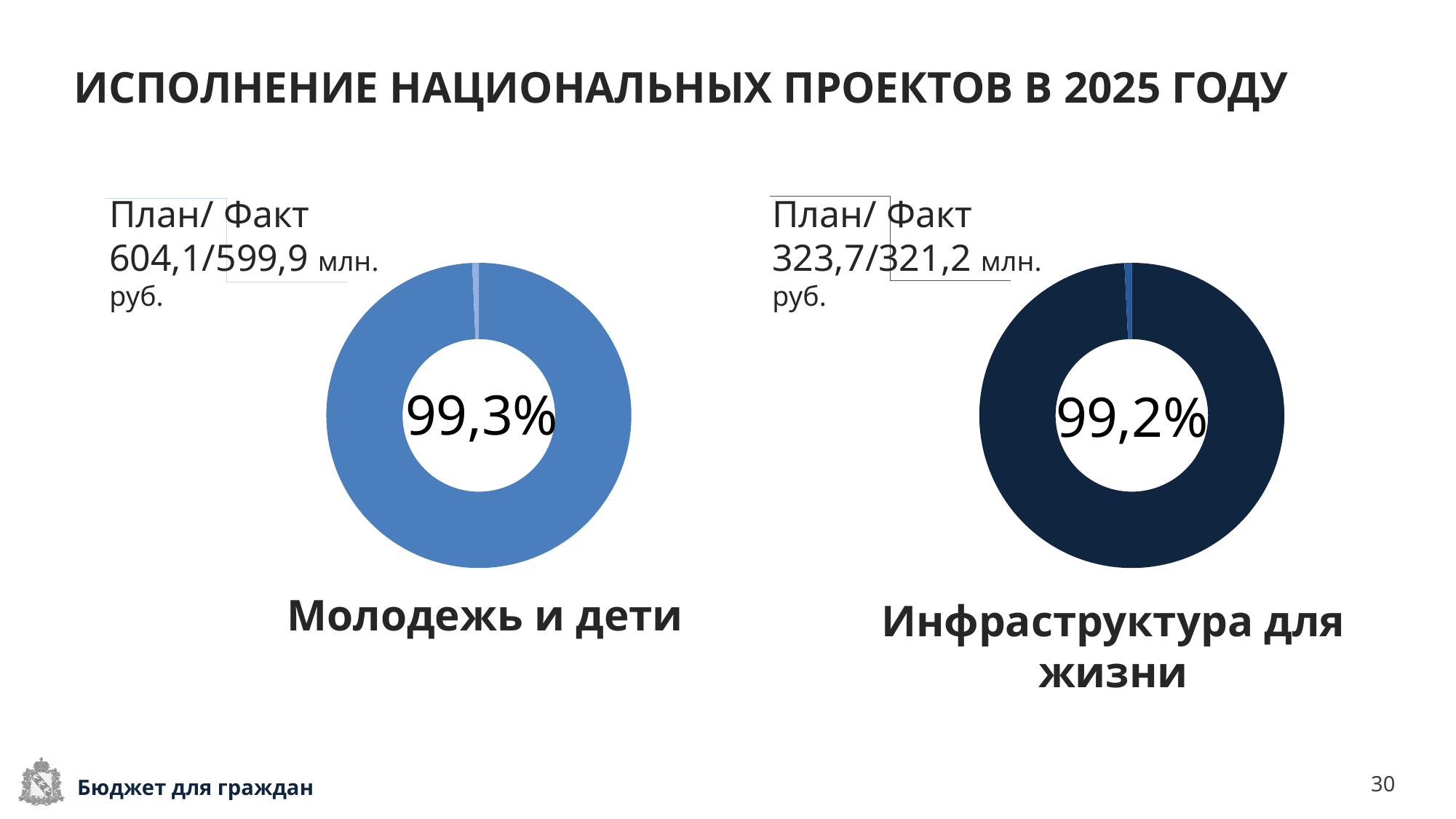
Which of the two national projects on the slide has the higher execution percentage? Молодежь и дети In the chart titled "Инфраструктура для жизни", what is the difference between the planned and actual amounts in млн. руб.? 2,5 How many donut charts are shown on the slide? 2 What is the title of the slide? ИСПОЛНЕНИЕ НАЦИОНАЛЬНЫХ ПРОЕКТОВ В 2025 ГОДУ In the chart titled "Инфраструктура для жизни", what is the planned amount (План) in млн. руб.? 323,7 In the chart titled "Молодежь и дети", what is the actual amount (Факт) in млн. руб.? 599,9 In the chart titled "Молодежь и дети", what is the planned amount (План) in млн. руб.? 604,1 In the chart titled "Молодежь и дети", what execution percentage is shown in the centre of the donut? 99,3% In the chart titled "Молодежь и дети", what is the difference between the planned and actual amounts in млн. руб.? 4,2 What kind of chart is used for "Молодежь и дети" on the left of the slide? Donut (pie) chart In the chart titled "Инфраструктура для жизни", what execution percentage is shown in the centre of the donut? 99,2% In the chart titled "Инфраструктура для жизни", what is the actual amount (Факт) in млн. руб.? 321,2